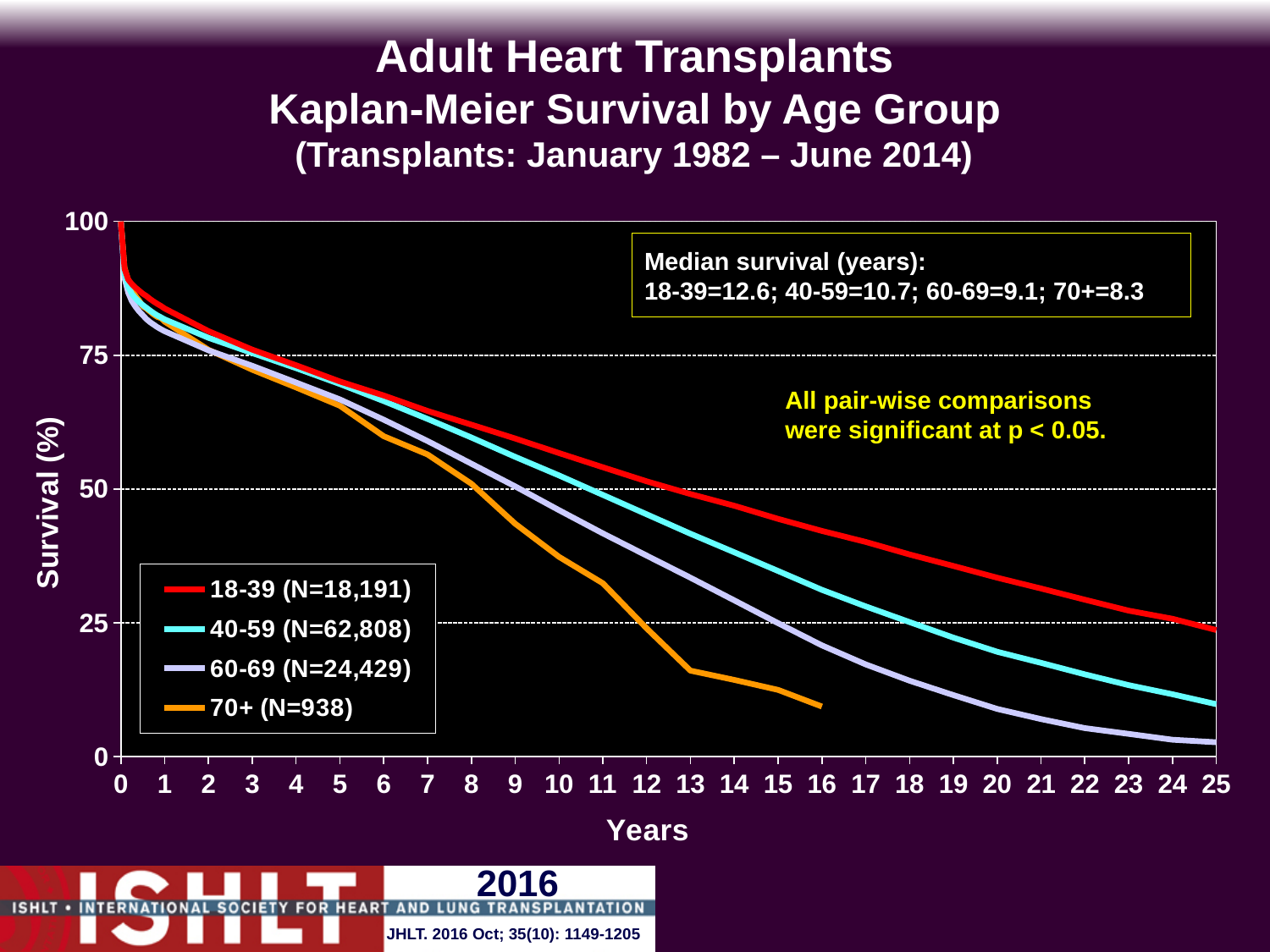
What kind of chart is shown on the slide? line chart What is the difference in median survival (years) between the 18-39 and 70+ age groups? 4.3 Which age group has the lowest median survival? 70+ Is the survival for the 40-59 group at 25 years greater or less than 25%? less Do the survival curves rise or fall as years increase? fall At 20 years, which group has higher survival: 18-39 or 60-69? 18-39 Is the survival for the 18-39 group at 10 years greater or less than 50%? greater What is the median survival in years for the 18-39 age group? 12.6 What is the N for the 40-59 age group shown in the legend? 62,808 How many age groups does the legend list? 4 What is the median survival in years for the 70+ age group? 8.3 Which age group has the highest survival at 15 years? 18-39